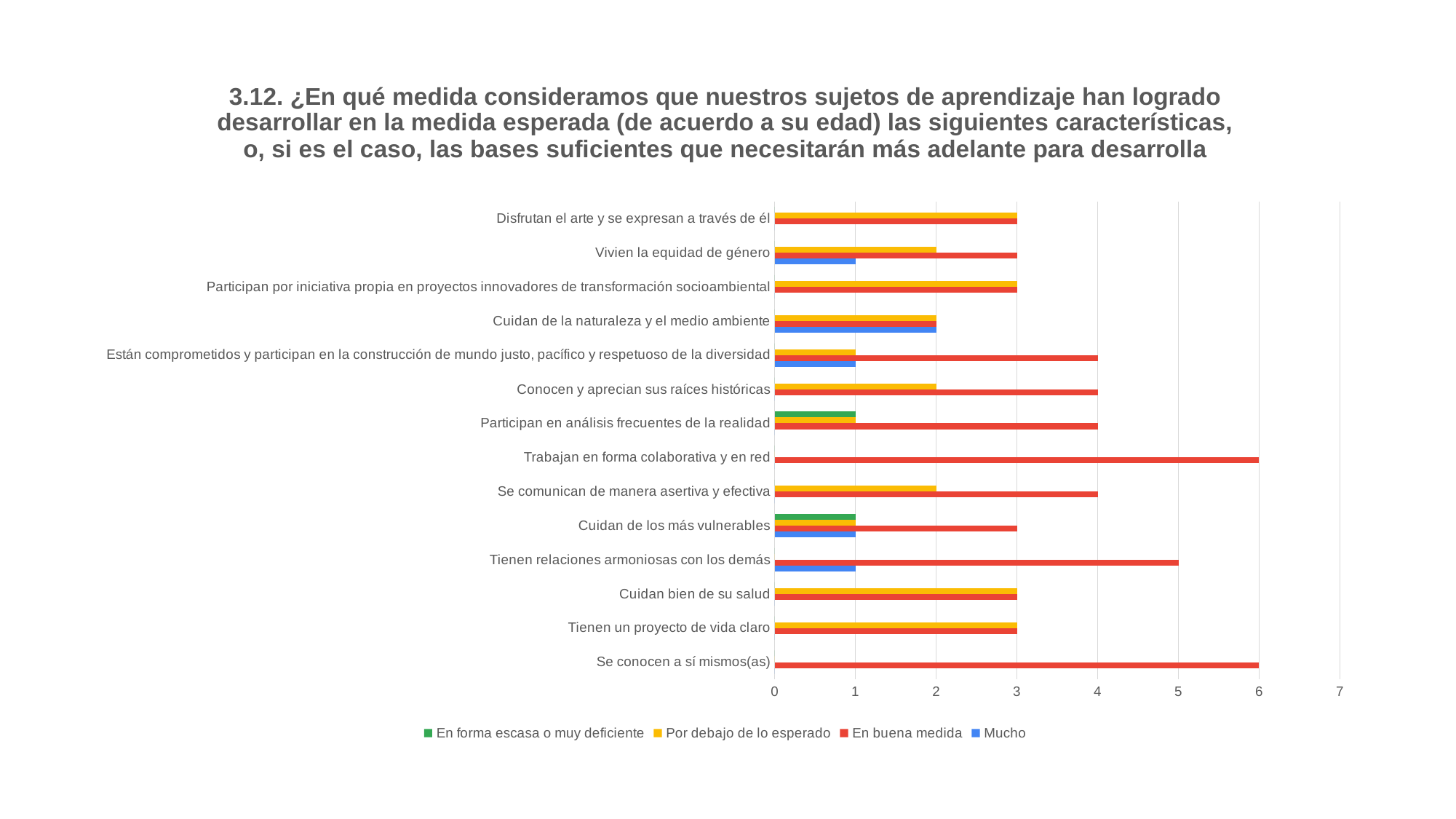
What is the value of "Mucho" for "Cuidan de la naturaleza y el medio ambiente"? 2 Is the "En buena medida" value for "Tienen relaciones armoniosas con los demás" greater or less than 4? greater What is the value of "En forma escasa o muy deficiente" for "Cuidan de los más vulnerables"? 1 What type of chart is shown on the slide? bar chart What is the difference between the "En buena medida" values for "Se conocen a sí mismos(as)" and "Cuidan bien de su salud"? 3 What is the value of "Por debajo de lo esperado" for "Conocen y aprecian sus raíces históricas"? 2 How many categories are plotted on the chart? 14 Which is larger for "Están comprometidos y participan en la construcción de mundo justo, pacífico y respetuoso de la diversidad": "En buena medida" or "Por debajo de lo esperado"? En buena medida How many series does the legend list? 4 What is the value of "En buena medida" for "Trabajan en forma colaborativa y en red"? 6 What is the value of "En buena medida" for "Tienen relaciones armoniosas con los demás"? 5 Which series is shown in green in the legend? En forma escasa o muy deficiente